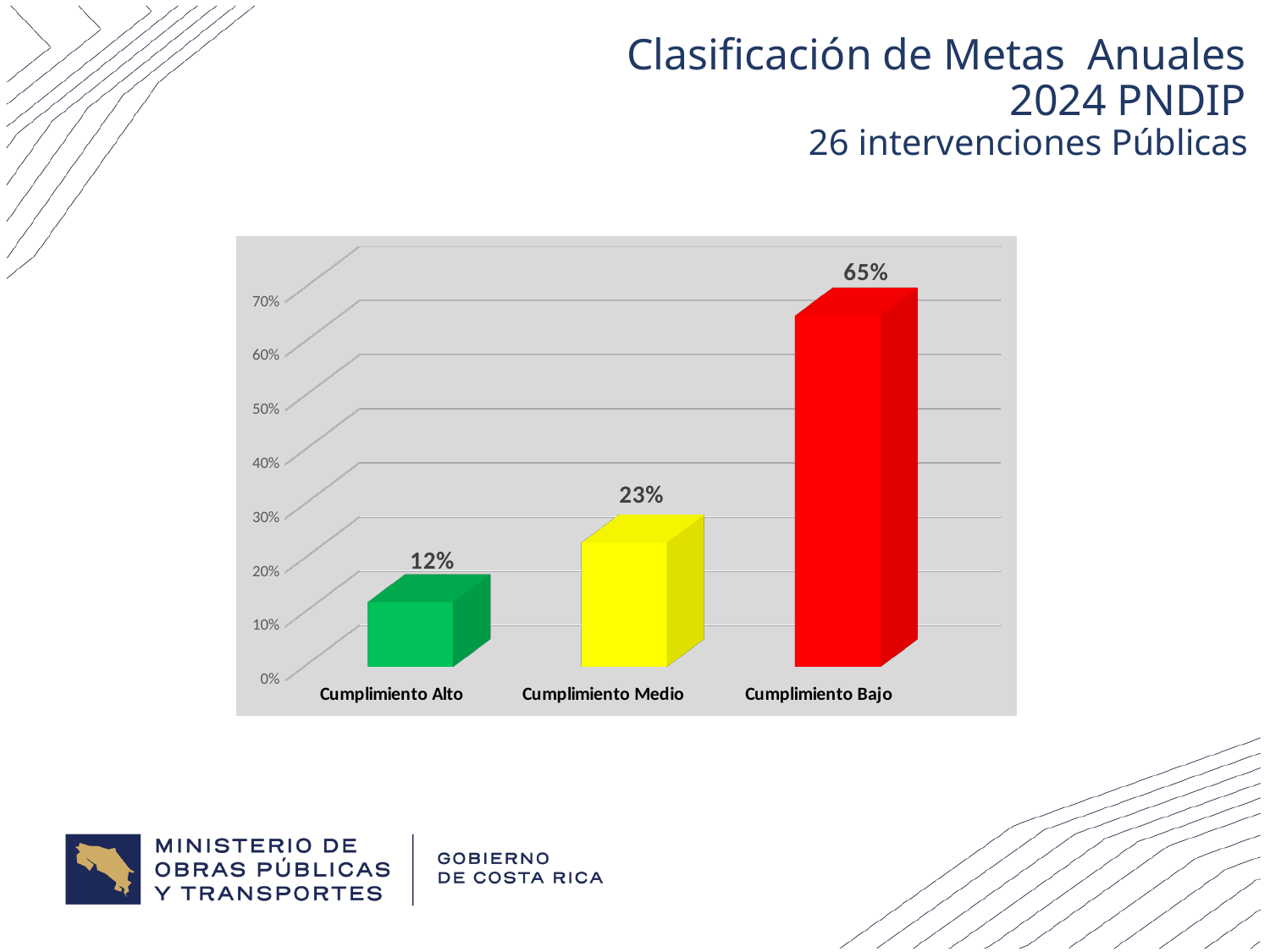
Which category has the highest value? Cumplimiento Bajo What is the difference between the values for Cumplimiento Bajo and Cumplimiento Medio? 42% Which is larger, the value for Cumplimiento Medio or the value for Cumplimiento Alto? Cumplimiento Medio What kind of chart is shown on the slide? bar chart How many categories are shown on the x axis? 3 What is the difference between the values for Cumplimiento Medio and Cumplimiento Alto? 11% Which category has the lowest value? Cumplimiento Alto What is the value for Cumplimiento Alto? 12% Is the value for Cumplimiento Bajo greater or less than 50%? greater What is the value for Cumplimiento Bajo? 65% What colour is the bar for Cumplimiento Bajo? red What is the value for Cumplimiento Medio? 23%